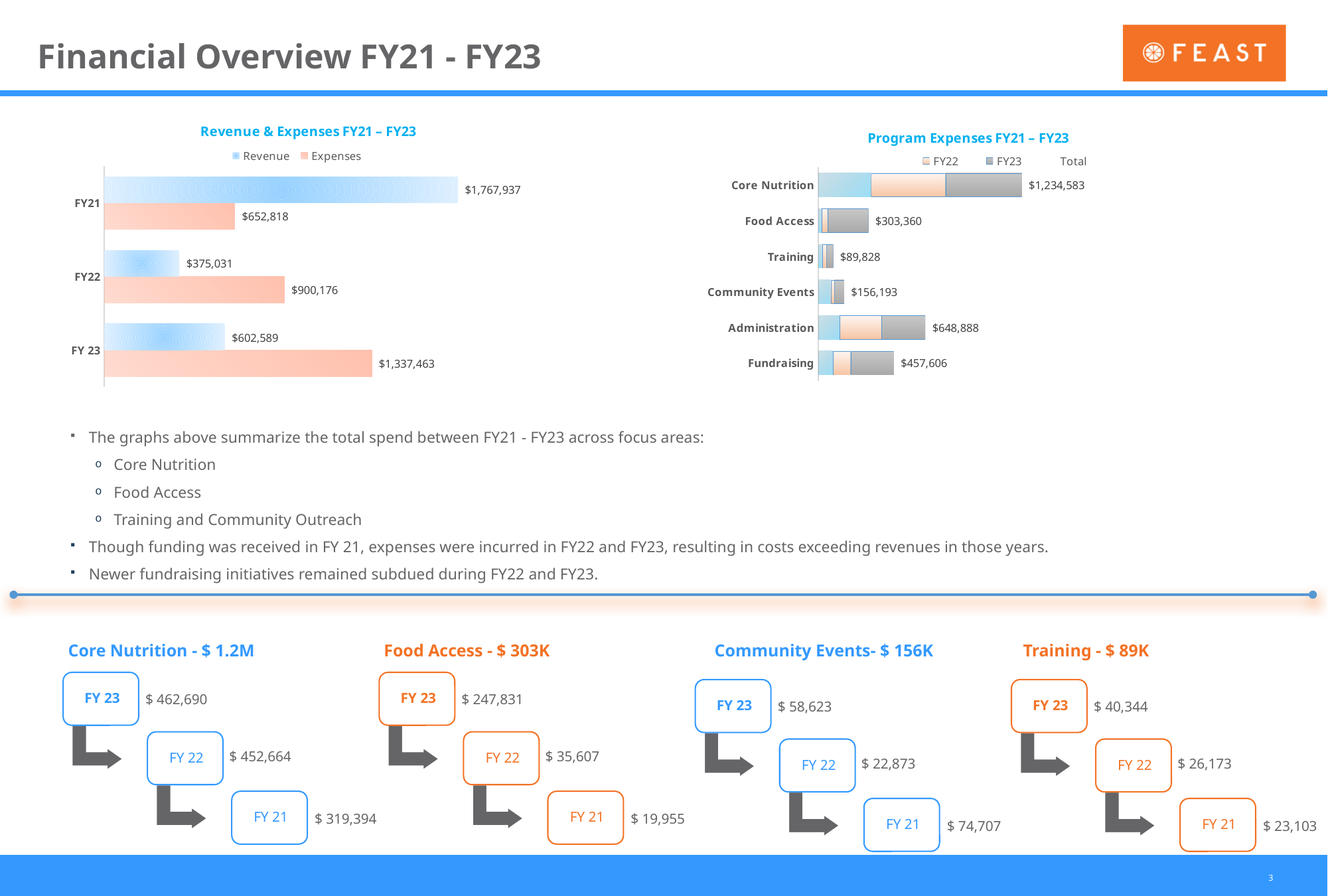
What kind of chart is the 'Revenue & Expenses FY21 – FY23' chart? Bar chart In the 'Program Expenses FY21 – FY23' chart, what is the difference between the Administration total and the Fundraising total? $191,282 In the 'Revenue & Expenses FY21 – FY23' chart, which fiscal year has the highest Revenue? FY21 In the 'Revenue & Expenses FY21 – FY23' chart, what is the Revenue value for FY21? $1,767,937 How many series does the legend of the 'Revenue & Expenses FY21 – FY23' chart list? 2 In the 'Revenue & Expenses FY21 – FY23' chart, what is the Expenses value for FY 23? $1,337,463 How many fiscal years are shown in the 'Revenue & Expenses FY21 – FY23' chart? 3 In the 'Program Expenses FY21 – FY23' chart, what is the total for Core Nutrition? $1,234,583 In the 'Revenue & Expenses FY21 – FY23' chart, which is larger for FY21, Revenue or Expenses? Revenue In the 'Revenue & Expenses FY21 – FY23' chart, by how much do Expenses exceed Revenue in FY22? $525,145 In the 'Program Expenses FY21 – FY23' chart, which category has the lowest total? Training How many categories are shown in the 'Program Expenses FY21 – FY23' chart? 6